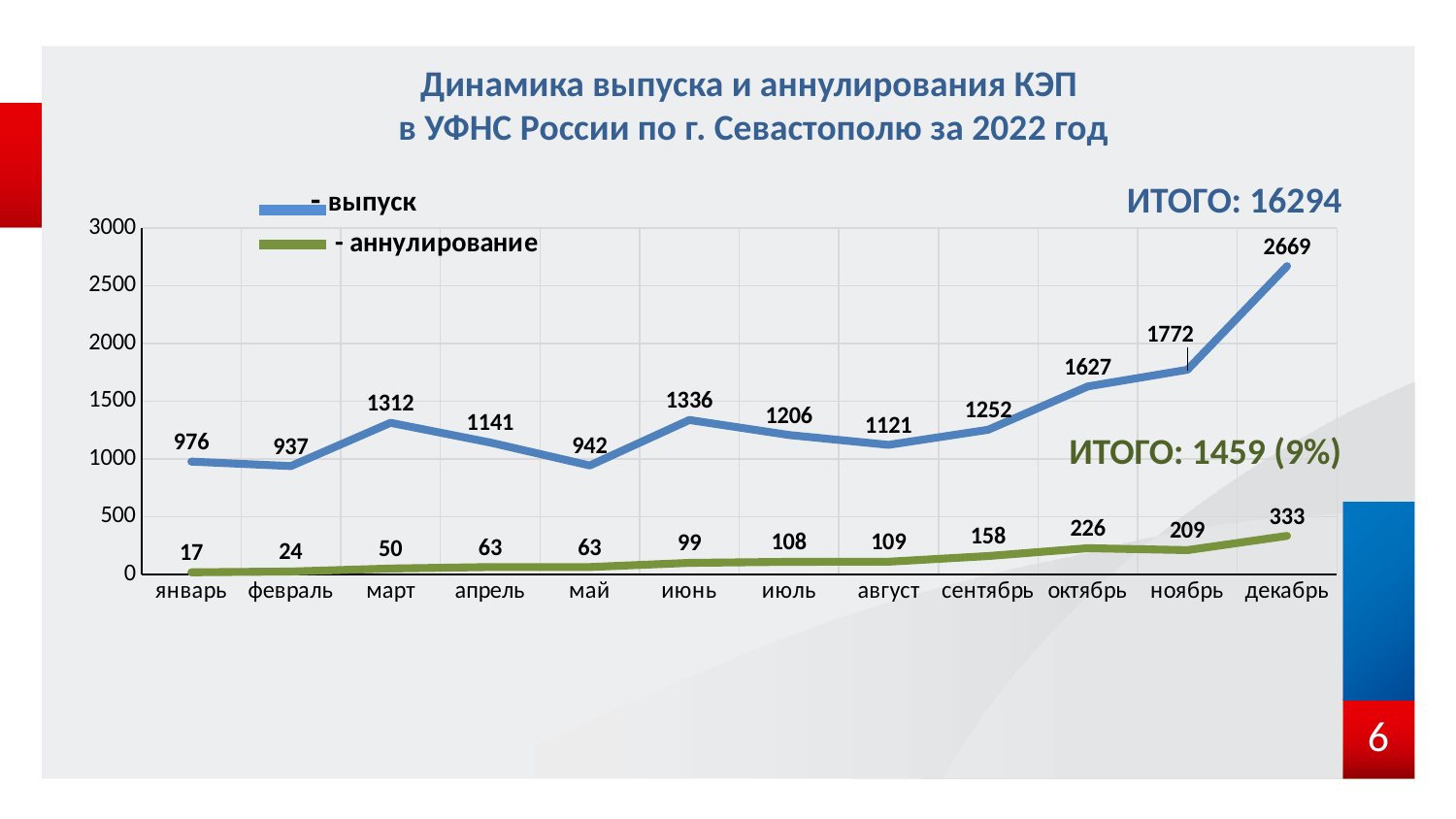
Does аннулирование generally rise or fall from январь to декабрь? rise In which month is выпуск highest? декабрь How many series does the legend list? 2 How many months are plotted on the x axis? 12 In which month is аннулирование lowest? январь What is the difference between выпуск in декабрь and выпуск in ноябрь? 897 What total (ИТОГО) is shown for выпуск? 16294 What is the value for выпуск in май? 942 Which is larger: выпуск in март or выпуск in июнь? июнь What is the value for аннулирование in октябрь? 226 What kind of chart is shown? line chart What is the value for выпуск in декабрь? 2669